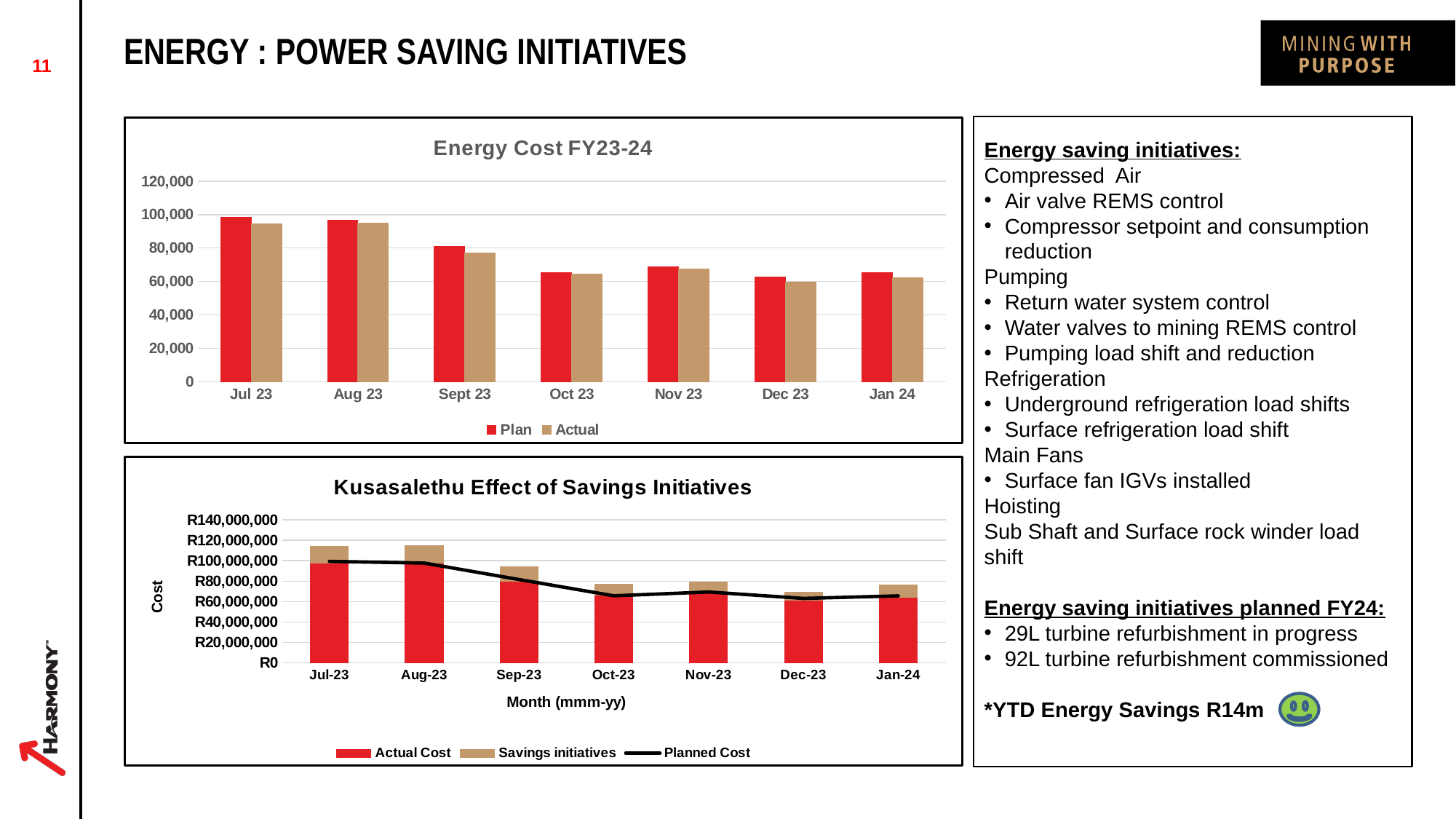
How many entries does the legend of the "Kusasalethu Effect of Savings Initiatives" chart list? 3 In the "Energy Cost FY23-24" chart, is the Plan value for Jul 23 greater or less than 80,000? greater In the "Energy Cost FY23-24" chart, is the Actual value for Oct 23 greater or less than 80,000? less How many months are shown on the x axis of the "Energy Cost FY23-24" chart? 7 In the "Kusasalethu Effect of Savings Initiatives" chart, is the Actual Cost for Jul-23 greater or less than R80,000,000? greater In the "Kusasalethu Effect of Savings Initiatives" chart, what is the label of the y axis? Cost In the "Energy Cost FY23-24" chart, which month has the lowest Actual value? Dec 23 What type of chart is the "Energy Cost FY23-24" chart? Bar chart In the "Energy Cost FY23-24" chart, do the Plan values generally rise or fall from Jul 23 to Jan 24? Fall In the "Energy Cost FY23-24" chart, which month has the highest Plan value? Jul 23 How many series does the legend of the "Energy Cost FY23-24" chart list? 2